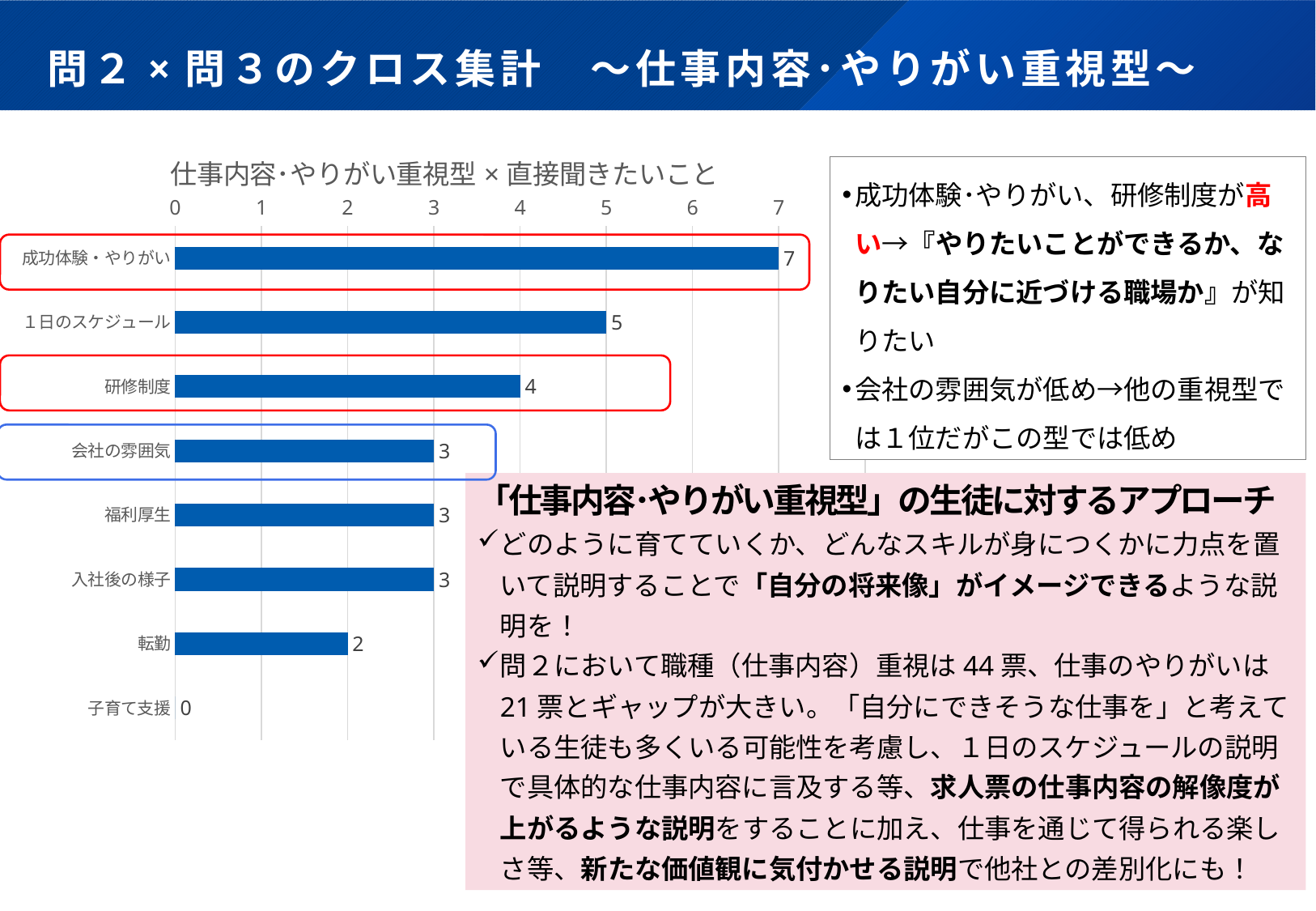
What kind of chart is shown on the slide? Bar chart What is the title of the chart? 仕事内容・やりがい重視型 × 直接聞きたいこと What is the value for 成功体験・やりがい? 7 What is the value for 研修制度? 4 What is the value for 転勤? 2 What is the difference between the values for 研修制度 and 転勤? 2 Which is larger, the value for 研修制度 or the value for 会社の雰囲気? 研修制度 Which category has the highest value? 成功体験・やりがい Which category has the lowest value? 子育て支援 How many categories are shown in the chart? 8 What is the value for 子育て支援? 0 What is the difference between the values for 成功体験・やりがい and １日のスケジュール? 2